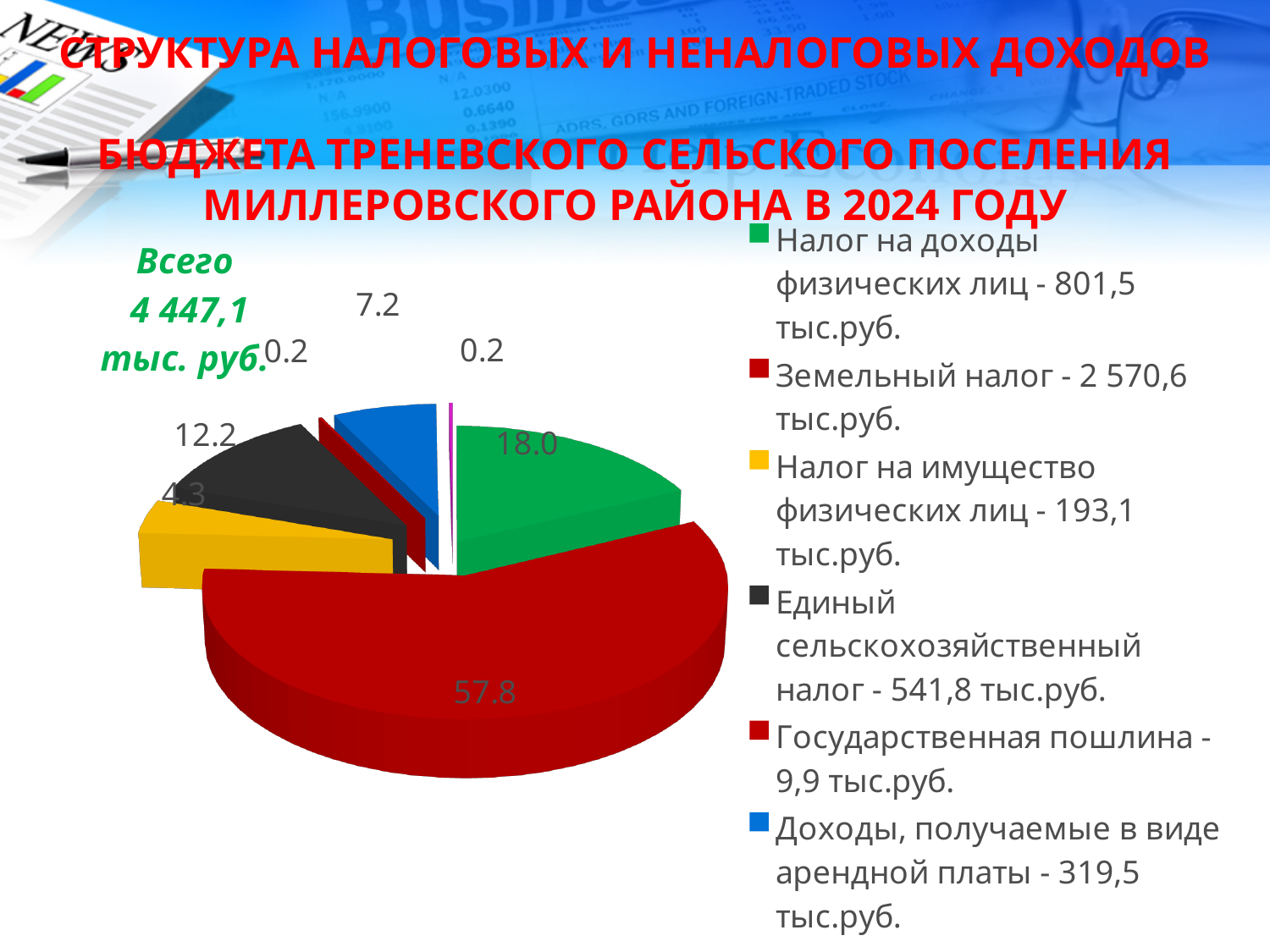
What kind of chart is shown on the slide? pie chart What is the data label on the green slice for Налог на доходы физических лиц? 18.0 What is the data label on the black slice for Единый сельскохозяйственный налог? 12.2 What is the data label on the blue slice for Доходы, получаемые в виде арендной платы? 7.2 According to the legend, what is the amount for Государственная пошлина? 9,9 тыс.руб. According to the legend, what is the amount for Земельный налог in тыс.руб.? 2 570,6 тыс.руб. What total amount (Всего) is shown next to the pie chart? 4 447,1 тыс. руб. What is the data label on the yellow slice for Налог на имущество физических лиц? 4.3 Which slice is larger: the black slice (Единый сельскохозяйственный налог) or the yellow slice (Налог на имущество физических лиц)? Единый сельскохозяйственный налог What is the data label on the red slice for Земельный налог? 57.8 Which category has the largest slice of the pie? Земельный налог What is the difference between the data labels of the red slice (57.8) and the green slice (18.0)? 39.8